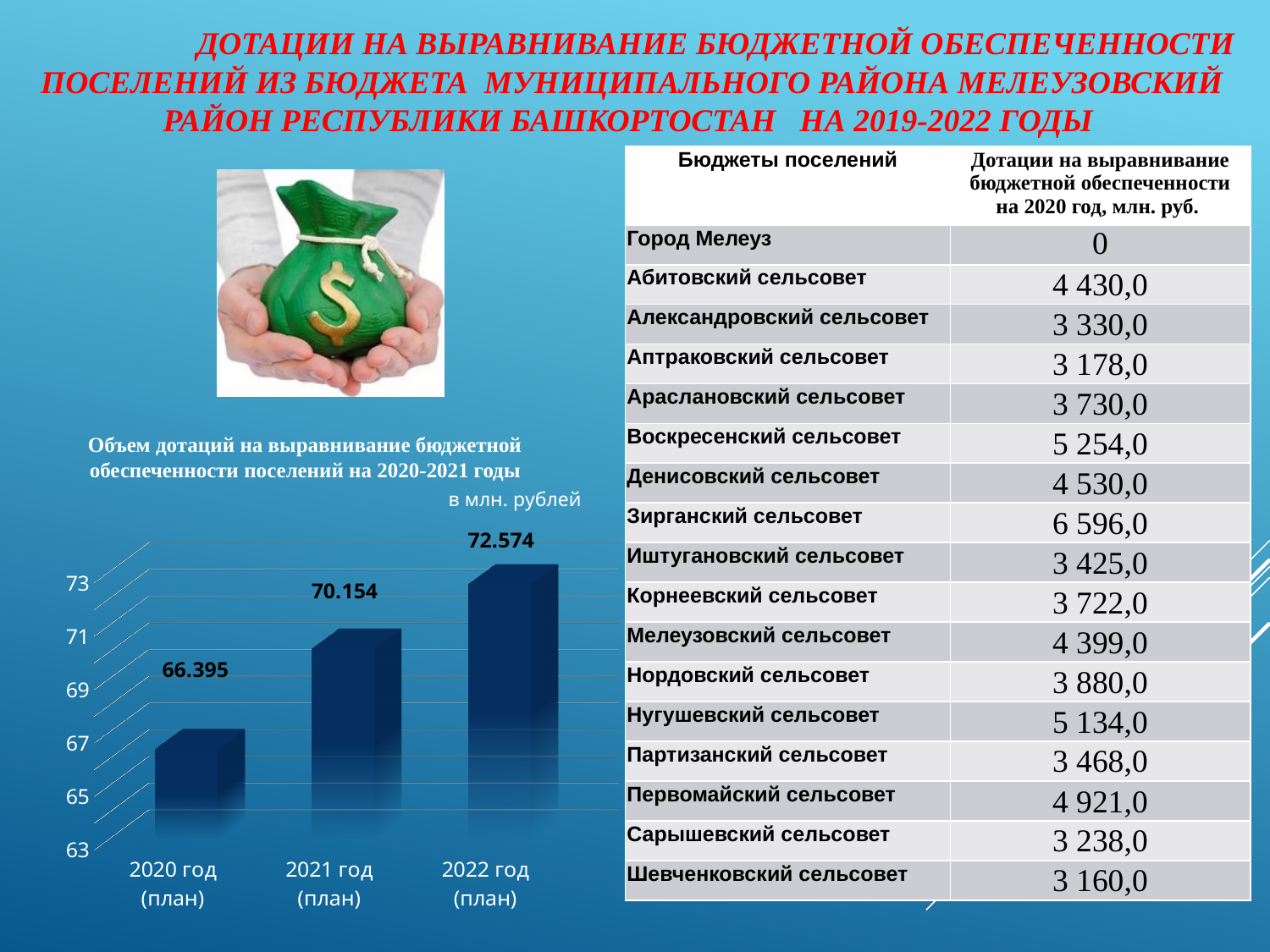
What is the difference between the values for 2021 год (план) and 2020 год (план)? 3.759 Which year has the highest value in the bar chart? 2022 год (план) What is the value for 2020 год (план) in the bar chart? 66.395 Do the values in the chart rise or fall from 2020 to 2022? rise What is the value for 2022 год (план) in the bar chart? 72.574 Is the value for 2021 год (план) greater or less than 69? greater How many bars are shown in the chart? 3 Which year has the lowest value in the bar chart? 2020 год (план) What is the difference between the values for 2022 год (план) and 2020 год (план)? 6.179 Which is larger: the value for 2021 год (план) or 2020 год (план)? 2021 год (план) What kind of chart is shown on the slide? bar chart What is the value for 2021 год (план) in the bar chart? 70.154